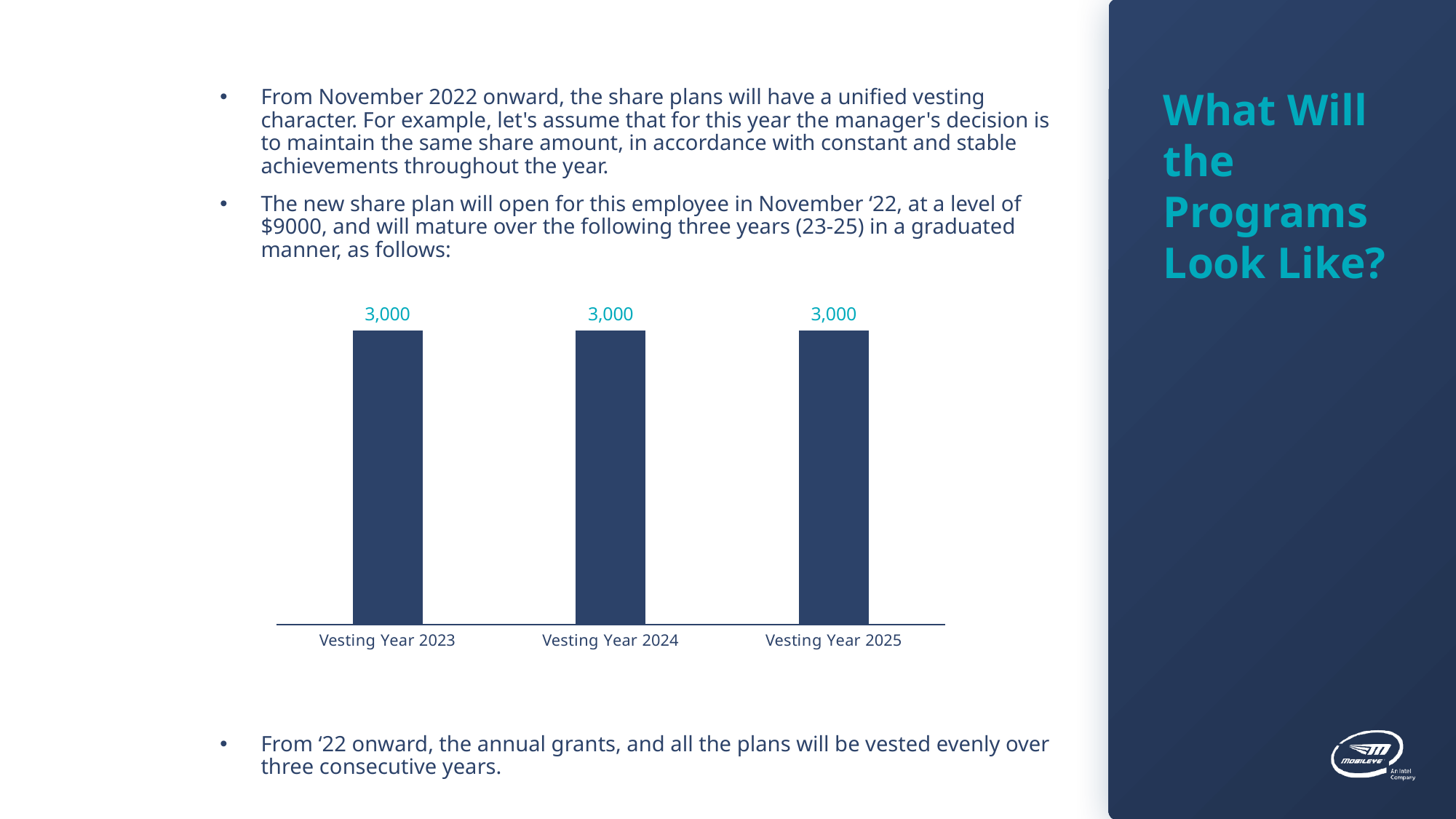
What is the value for Vesting Year 2025? 3,000 Do the values rise, fall, or stay the same from Vesting Year 2023 to Vesting Year 2025? stay the same What is the label of the first category on the x axis? Vesting Year 2023 What colour are the bars in the chart? dark blue What kind of chart is shown on the slide? bar chart What is the value for Vesting Year 2024? 3,000 How many categories are shown on the x axis of the chart? 3 What is the difference between the values for Vesting Year 2023 and Vesting Year 2025? 0 What is the total of the three bars in the chart? 9,000 What is the value for Vesting Year 2023? 3,000